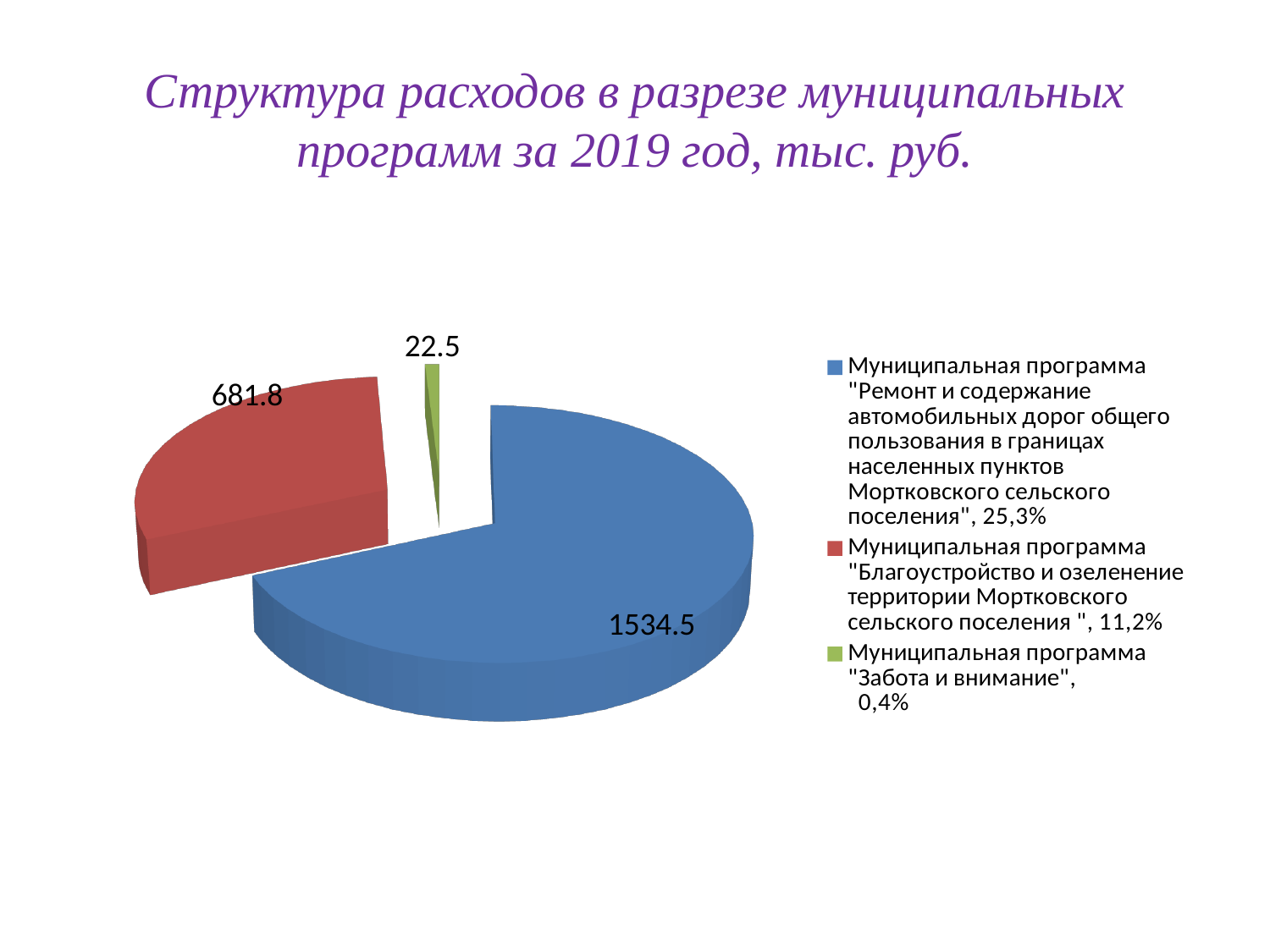
Which municipal program has the largest slice of the pie? Муниципальная программа "Ремонт и содержание автомобильных дорог общего пользования в границах населенных пунктов Мортковского сельского поселения" What type of chart is shown on the slide? Pie chart What is the value for the municipal program "Благоустройство и озеленение территории Мортковского сельского поселения"? 681.8 What is the value for the municipal program "Забота и внимание"? 22.5 Which is larger: the value for "Благоустройство и озеленение территории Мортковского сельского поселения" or the value for "Забота и внимание"? Благоустройство и озеленение территории Мортковского сельского поселения What is the difference between the value for the road repair program ("Ремонт и содержание автомобильных дорог...") and the landscaping program ("Благоустройство и озеленение...")? 852.7 What is the value for the municipal program "Ремонт и содержание автомобильных дорог общего пользования в границах населенных пунктов Мортковского сельского поселения"? 1534.5 What percentage is shown in the legend for the municipal program "Забота и внимание"? 0,4% How many slices does the pie chart have? 3 What colour is the slice for the municipal program "Благоустройство и озеленение территории Мортковского сельского поселения"? Red What is the difference between the value for the landscaping program ("Благоустройство и озеленение...") and the program "Забота и внимание"? 659.3 Which municipal program has the smallest slice of the pie? Муниципальная программа "Забота и внимание"